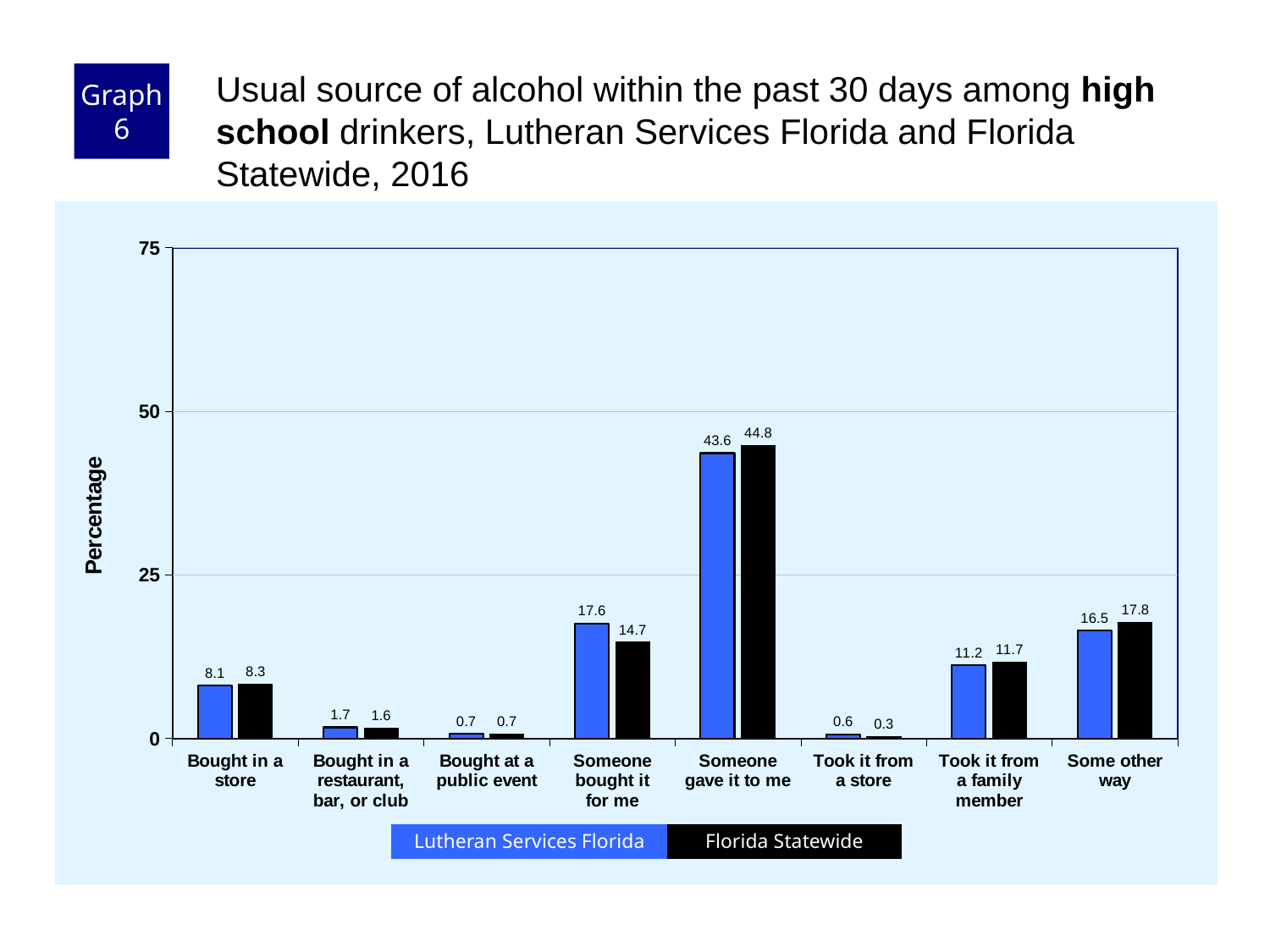
Which category has the highest Florida Statewide value? Someone gave it to me Which category has the lowest Florida Statewide value? Took it from a store What is the label of the y axis? Percentage What is the Lutheran Services Florida value for "Someone gave it to me"? 43.6 What is the difference between the Lutheran Services Florida and Florida Statewide values for "Someone bought it for me"? 2.9 Is the Florida Statewide value for "Someone gave it to me" greater or less than 50? less What is the Florida Statewide value for "Took it from a family member"? 11.7 For "Some other way", which series has the larger value, Lutheran Services Florida or Florida Statewide? Florida Statewide How many categories are shown on the x axis? 8 What is the Lutheran Services Florida value for "Bought in a store"? 8.1 How many series does the legend list? 2 What kind of chart is shown on the slide? Bar chart